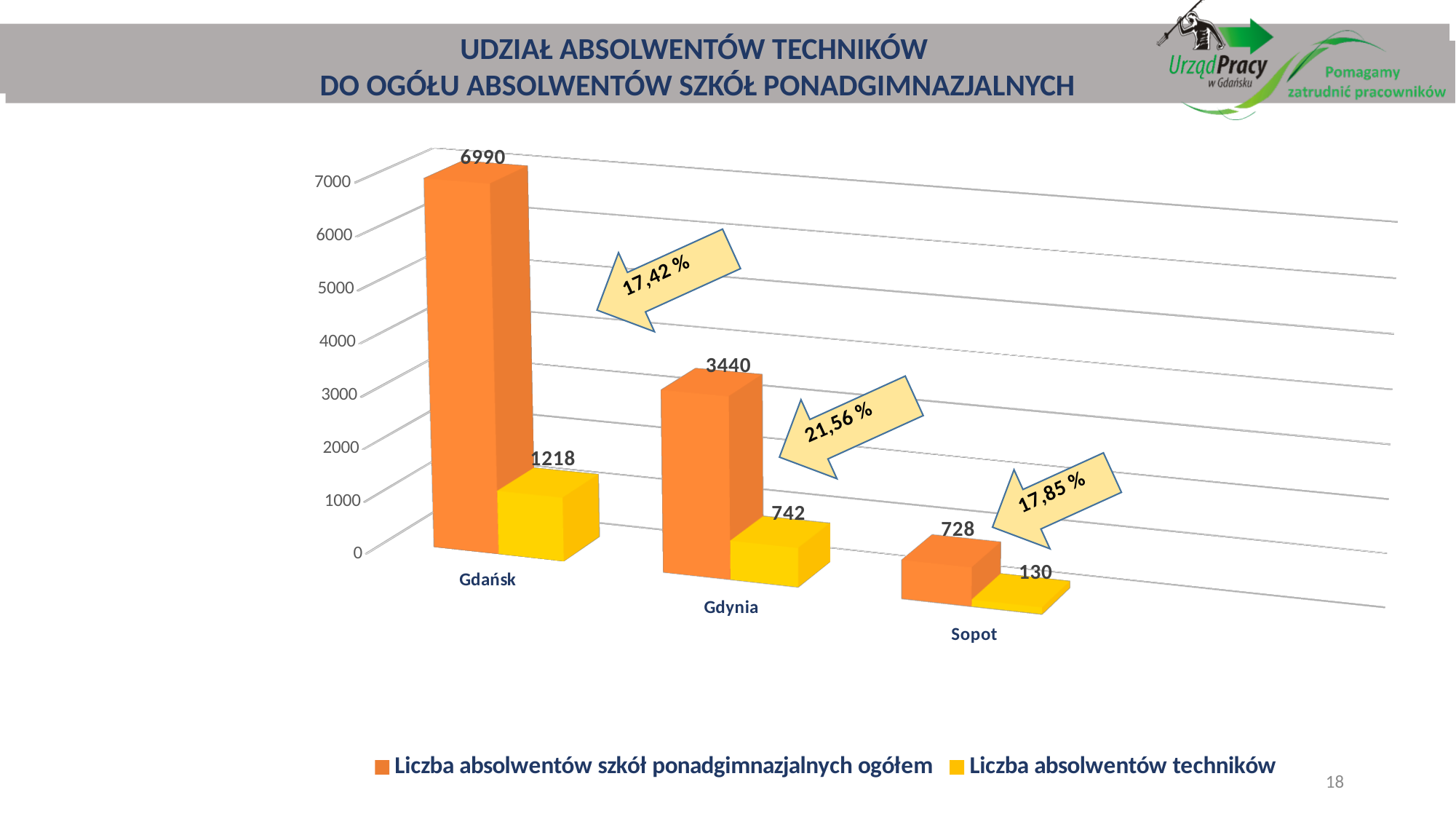
Is the value of 'Liczba absolwentów szkół ponadgimnazjalnych ogółem' for Gdynia greater or less than 3000? greater What is the value of 'Liczba absolwentów techników' for Sopot? 130 How many series does the legend list? 2 Which is larger: 'Liczba absolwentów techników' for Gdańsk or 'Liczba absolwentów szkół ponadgimnazjalnych ogółem' for Sopot? Liczba absolwentów techników for Gdańsk What is the difference between 'Liczba absolwentów szkół ponadgimnazjalnych ogółem' and 'Liczba absolwentów techników' for Gdynia? 2698 What is the value of 'Liczba absolwentów szkół ponadgimnazjalnych ogółem' for Gdańsk? 6990 How many cities are shown on the x axis? 3 What is the value of 'Liczba absolwentów techników' for Gdynia? 742 Which city has the highest value for 'Liczba absolwentów szkół ponadgimnazjalnych ogółem'? Gdańsk What percentage is shown in the arrow callout for Gdynia? 21,56 % What kind of chart is shown on the slide? bar chart Which city has the lowest value for 'Liczba absolwentów techników'? Sopot